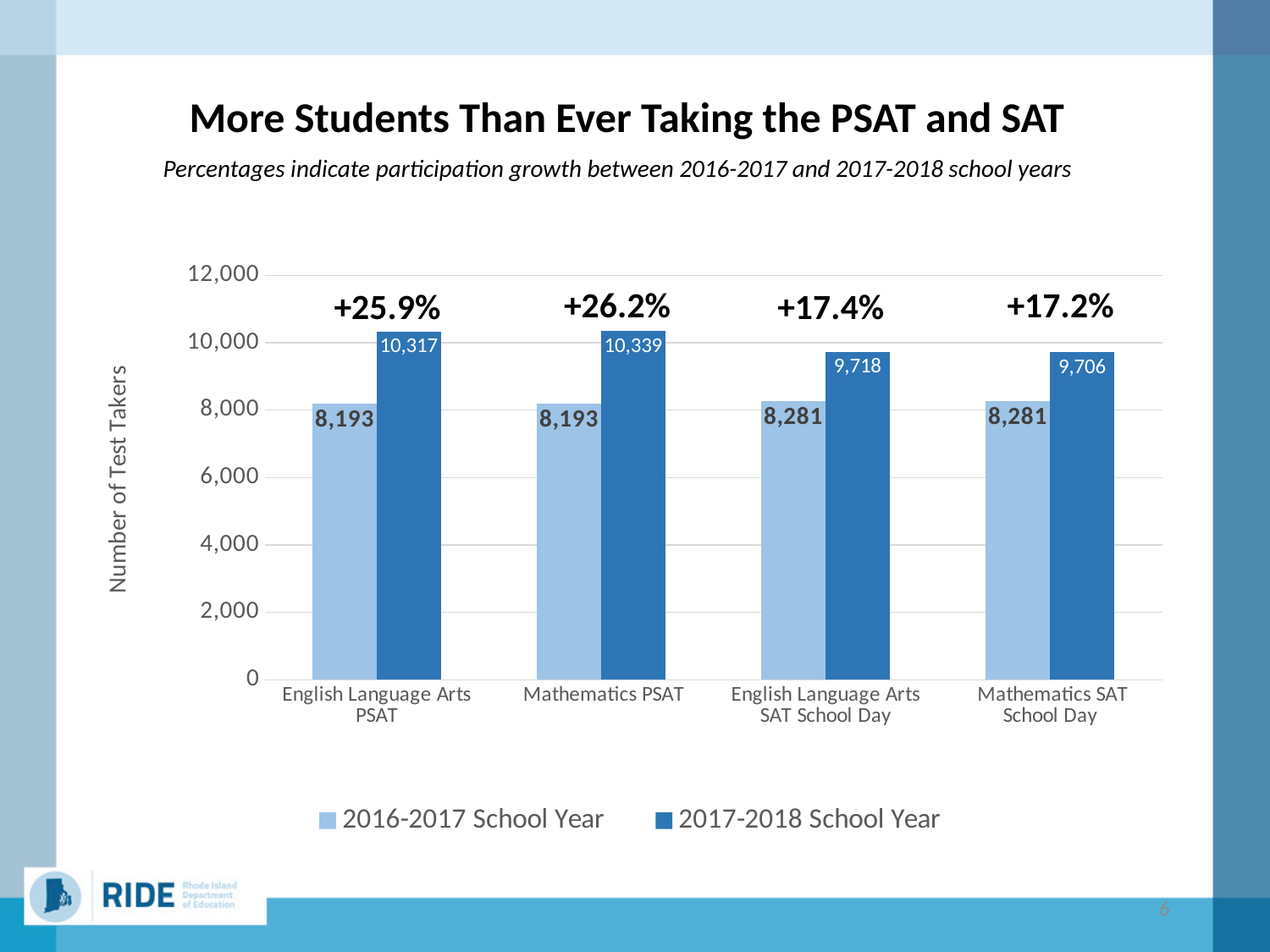
How many series does the legend list? 2 Which category has the highest number of test takers in the 2017-2018 School Year? Mathematics PSAT Is the 2017-2018 value for English Language Arts SAT School Day greater or less than 10,000? less How many categories are shown on the x axis? 4 Which category has the lowest number of test takers in the 2017-2018 School Year? Mathematics SAT School Day Which is larger: the 2016-2017 value for English Language Arts PSAT or the 2016-2017 value for English Language Arts SAT School Day? English Language Arts SAT School Day What kind of chart is shown on the slide? bar chart What is the number of test takers for Mathematics SAT School Day in the 2017-2018 School Year? 9,706 What is the difference between the 2017-2018 and 2016-2017 values for English Language Arts PSAT? 2,124 What is the number of test takers for Mathematics PSAT in the 2017-2018 School Year? 10,339 What is the number of test takers for English Language Arts SAT School Day in the 2016-2017 School Year? 8,281 What percentage growth is shown above the Mathematics PSAT bars? +26.2%